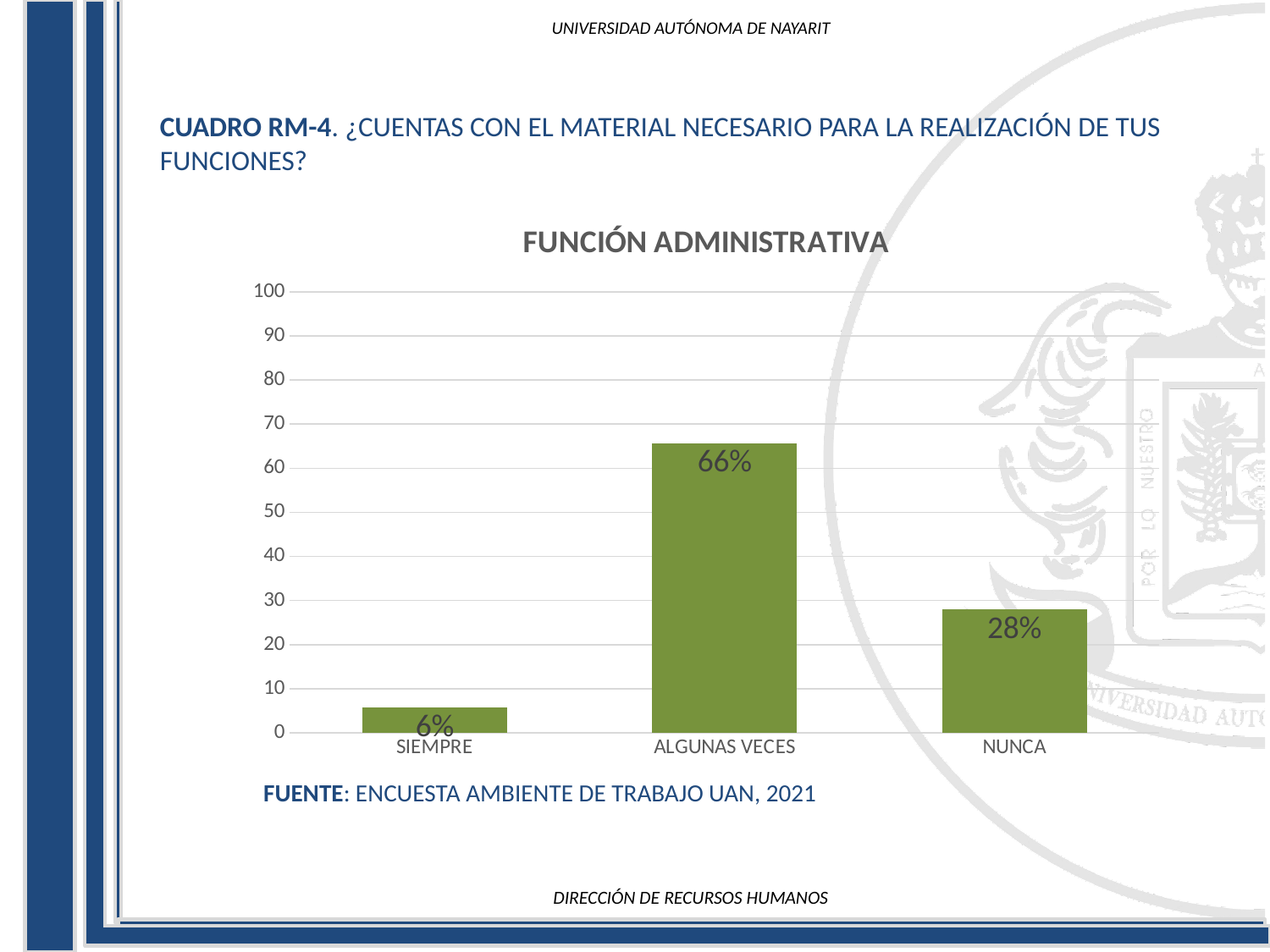
What is the value for ALGUNAS VECES? 66% Which is larger, the value for NUNCA or the value for SIEMPRE? NUNCA What is the difference between the values for ALGUNAS VECES and NUNCA? 38% What kind of chart is shown on the slide? bar chart How many categories are shown on the x axis? 3 What is the value for NUNCA? 28% What is the title of the chart? FUNCIÓN ADMINISTRATIVA Which category has the lowest value? SIEMPRE What is the value for SIEMPRE? 6% What is the difference between the values for NUNCA and SIEMPRE? 22% Which category has the highest value? ALGUNAS VECES Is the value for ALGUNAS VECES greater or less than 50? greater